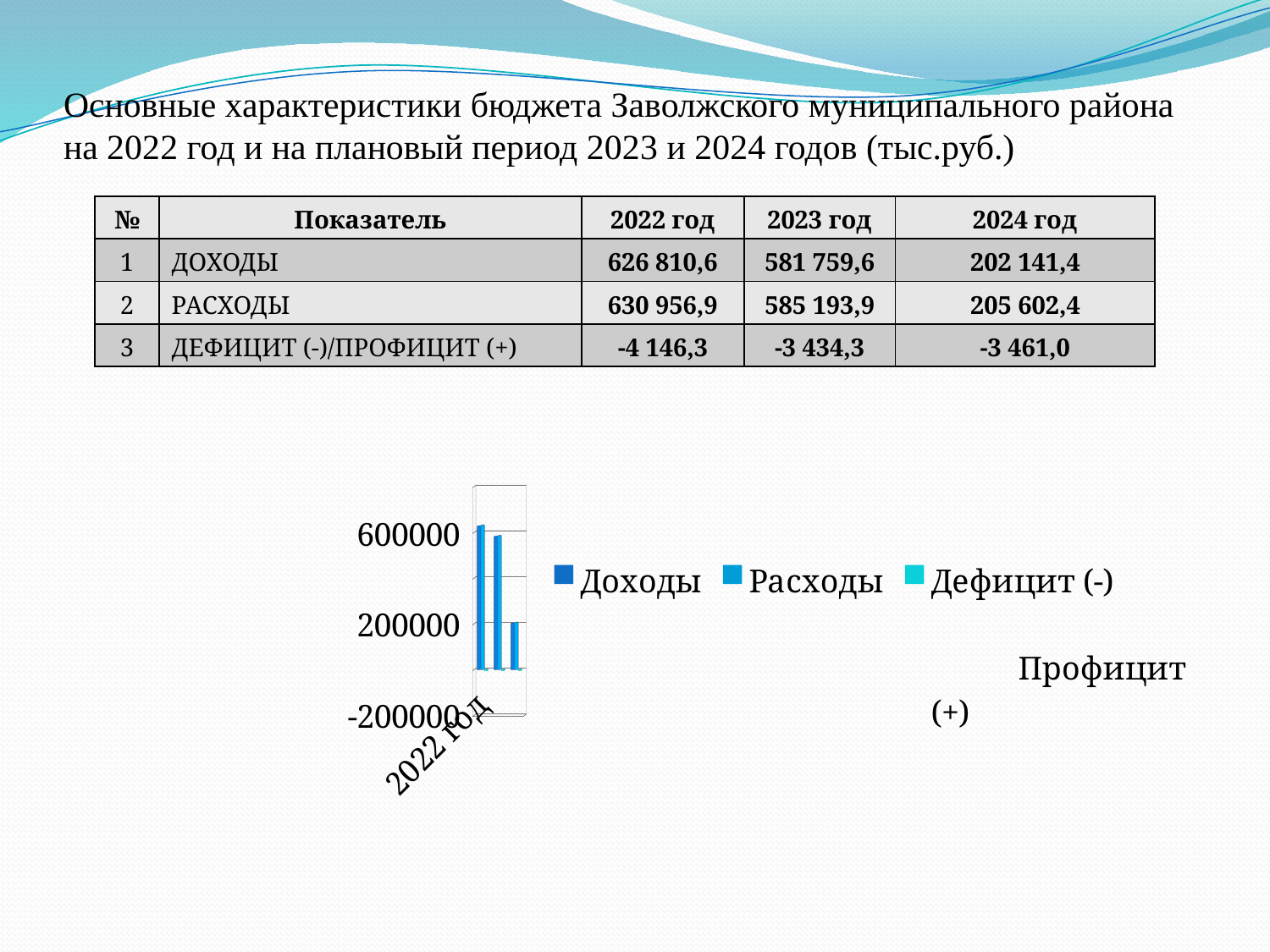
Is the value of the second bar in the chart greater or less than 200000? greater How many series does the chart legend list? 3 What kind of chart is shown on the slide? bar chart What are the entries in the chart legend? Доходы, Расходы, Дефицит (-) Профицит (+) Which bar in the chart is the shortest? the third (rightmost) bar Which is larger in the chart, the first bar or the third bar? the first bar What category label is shown on the x axis of the chart? 2022 год Is the value of the third (rightmost) bar in the chart greater or less than 600000? less What is the highest value labelled on the chart's vertical axis? 600000 Is the value of the first (leftmost) bar in the chart greater or less than 200000? greater